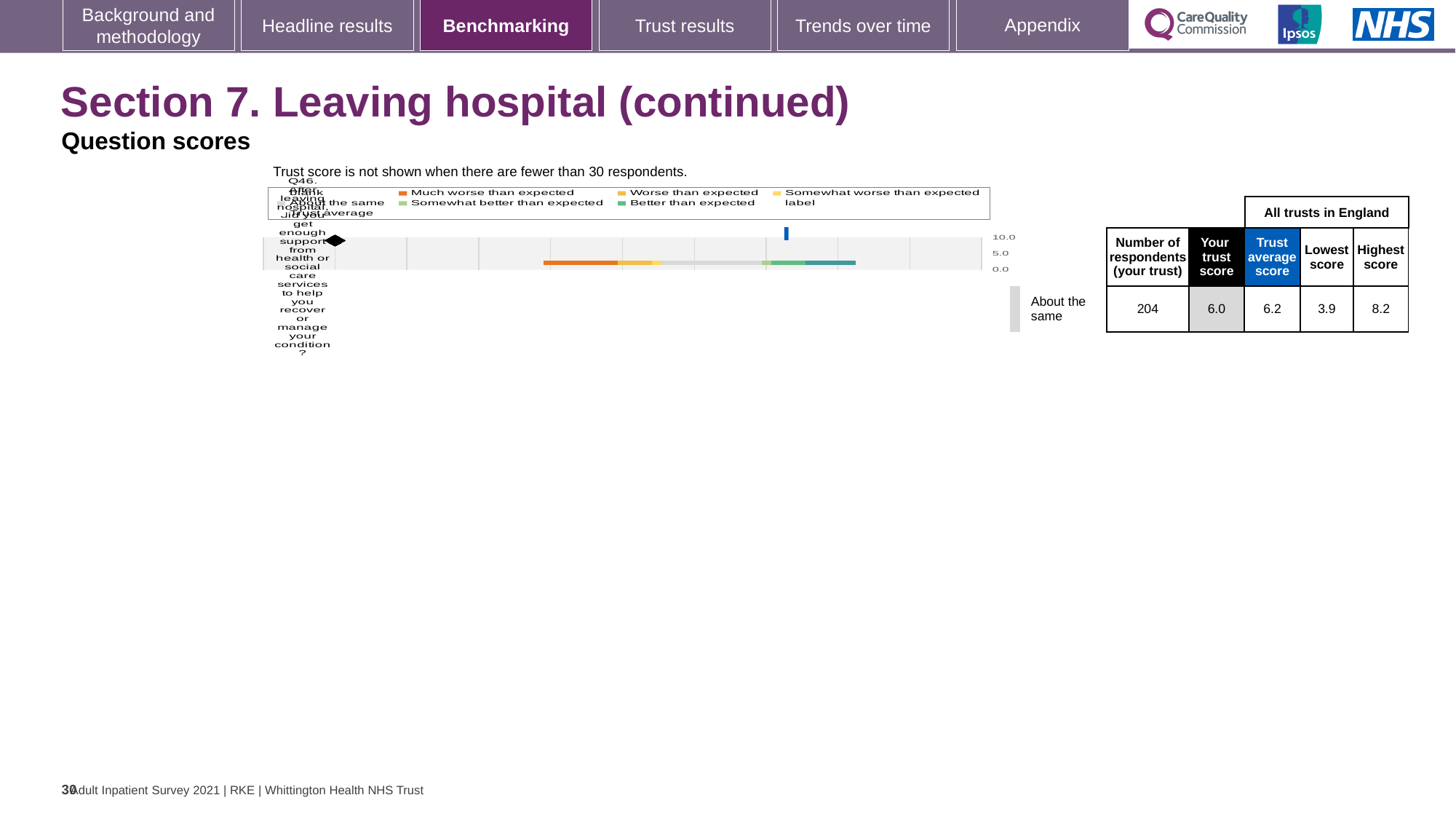
What is the highest score for Q46 among all trusts in England? 8.2 Is your trust score for Q46 greater or less than 5.0? greater What is the trust average score for Q46 across all trusts in England? 6.2 How many questions are plotted on the benchmarking chart on this slide? 1 Which is larger for Q46: your trust score or the trust average score? Trust average score What is the number of respondents (your trust) for Q46 shown in the table? 204 What is the lowest score for Q46 among all trusts in England? 3.9 What is the difference between the trust average score and your trust score for Q46? 0.2 What benchmark category is the trust's Q46 result labelled as next to the chart? About the same What is the difference between the highest score and the lowest score for Q46? 4.3 What is the trust's score for Q46 (Your trust score)? 6.0 What kind of chart is used to show the Q46 benchmarking result? Bar chart